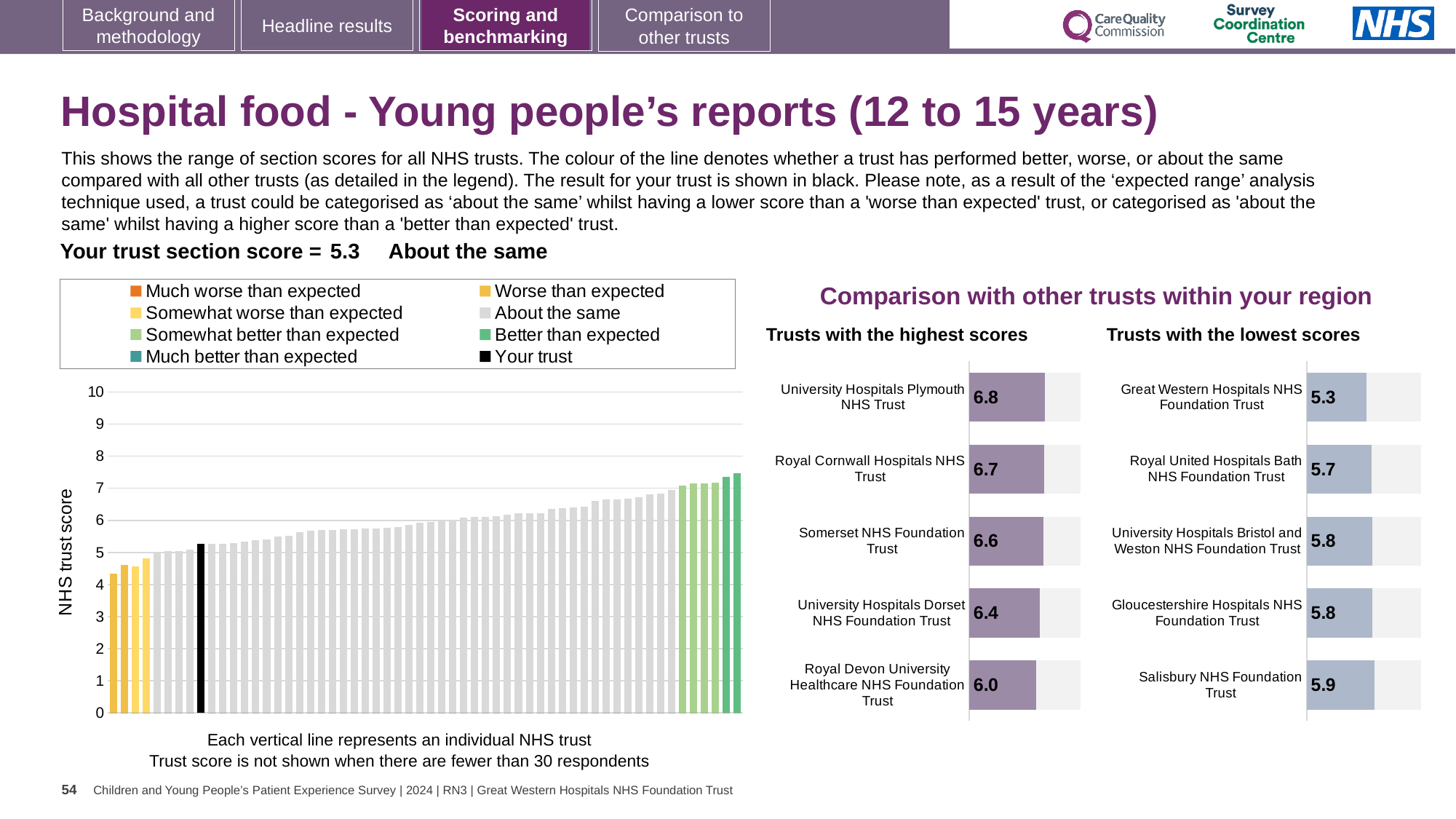
In the 'Trusts with the highest scores' chart, what is the difference between the scores of University Hospitals Plymouth NHS Trust and Royal Devon University Healthcare NHS Foundation Trust? 0.8 In the left-hand chart, is the value of the tallest bar greater or less than 7? greater In the left-hand chart, do the bar heights rise or fall from left to right? rise In the 'Trusts with the highest scores' chart, which trust has the highest score? University Hospitals Plymouth NHS Trust How many trusts are shown in the 'Trusts with the lowest scores' chart? 5 In the 'Trusts with the lowest scores' chart, what is the score for Gloucestershire Hospitals NHS Foundation Trust? 5.8 In the 'Trusts with the lowest scores' chart, which trust has the lowest score? Great Western Hospitals NHS Foundation Trust What kind of chart is the large chart on the left showing NHS trust scores? bar chart In the 'Trusts with the highest scores' chart, what is the score for Somerset NHS Foundation Trust? 6.6 In the left-hand chart, what is the section score for your trust (the black bar)? 5.3 How many entries does the legend above the left-hand chart list? 8 In the 'Trusts with the lowest scores' chart, which has the larger score: Royal United Hospitals Bath NHS Foundation Trust or Salisbury NHS Foundation Trust? Salisbury NHS Foundation Trust